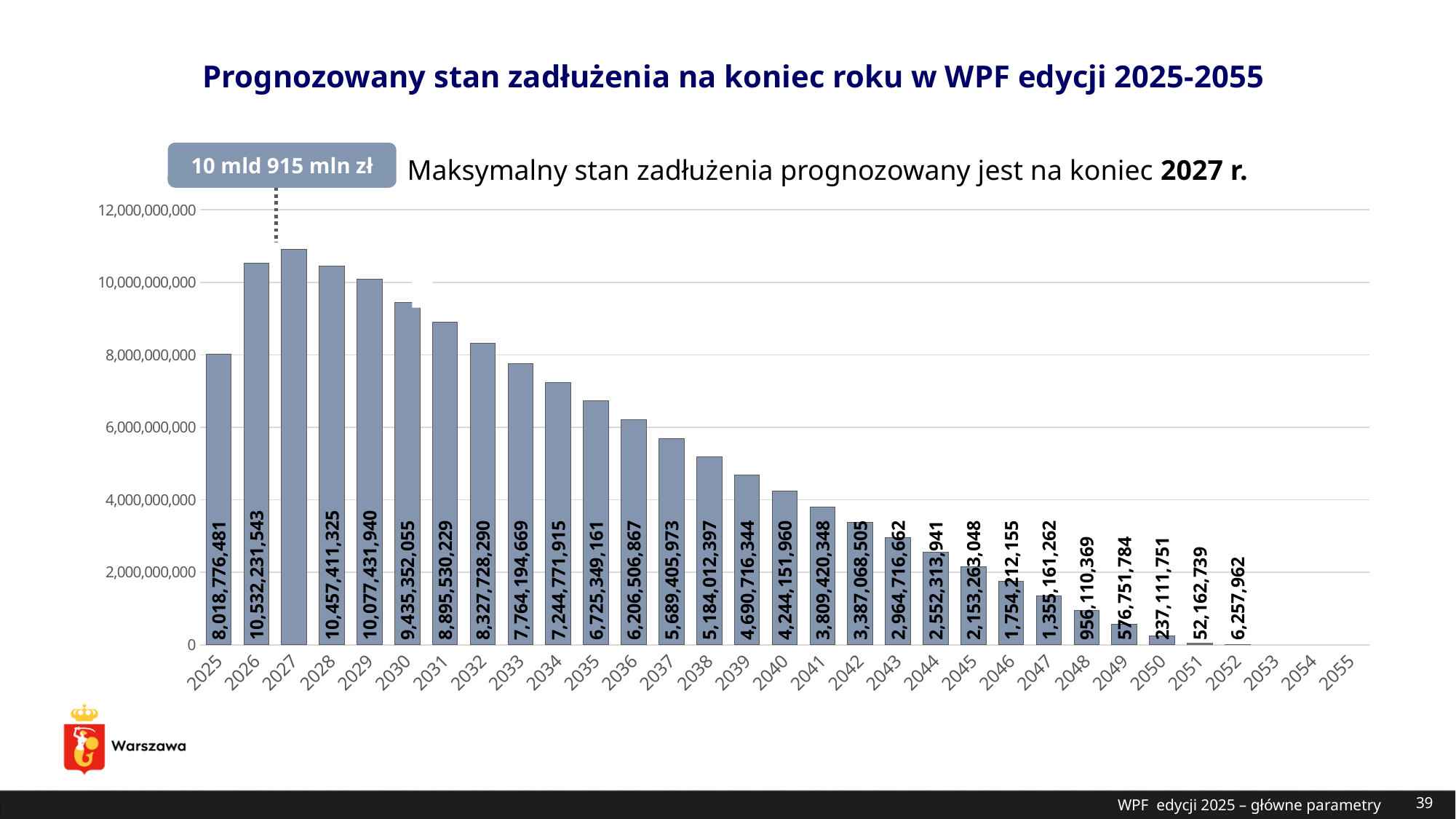
Is the value for 2027 greater or less than 10,000,000,000? greater What is the difference between the values for 2026 and 2025? 2,513,455,062 Which is larger, the value for 2026 or the value for 2028? 2026 Which year has the highest projected debt? 2027 What is the projected debt value for 2052? 6,257,962 What is the projected debt value for 2025? 8,018,776,481 How many years are shown on the x axis? 31 What is the projected debt value for 2040? 4,244,151,960 What is the projected debt value for 2030? 9,435,352,055 What is the title of the chart? Prognozowany stan zadłużenia na koniec roku w WPF edycji 2025-2055 Do the values rise or fall from 2027 to 2052? Fall What kind of chart is shown on the slide? Bar chart